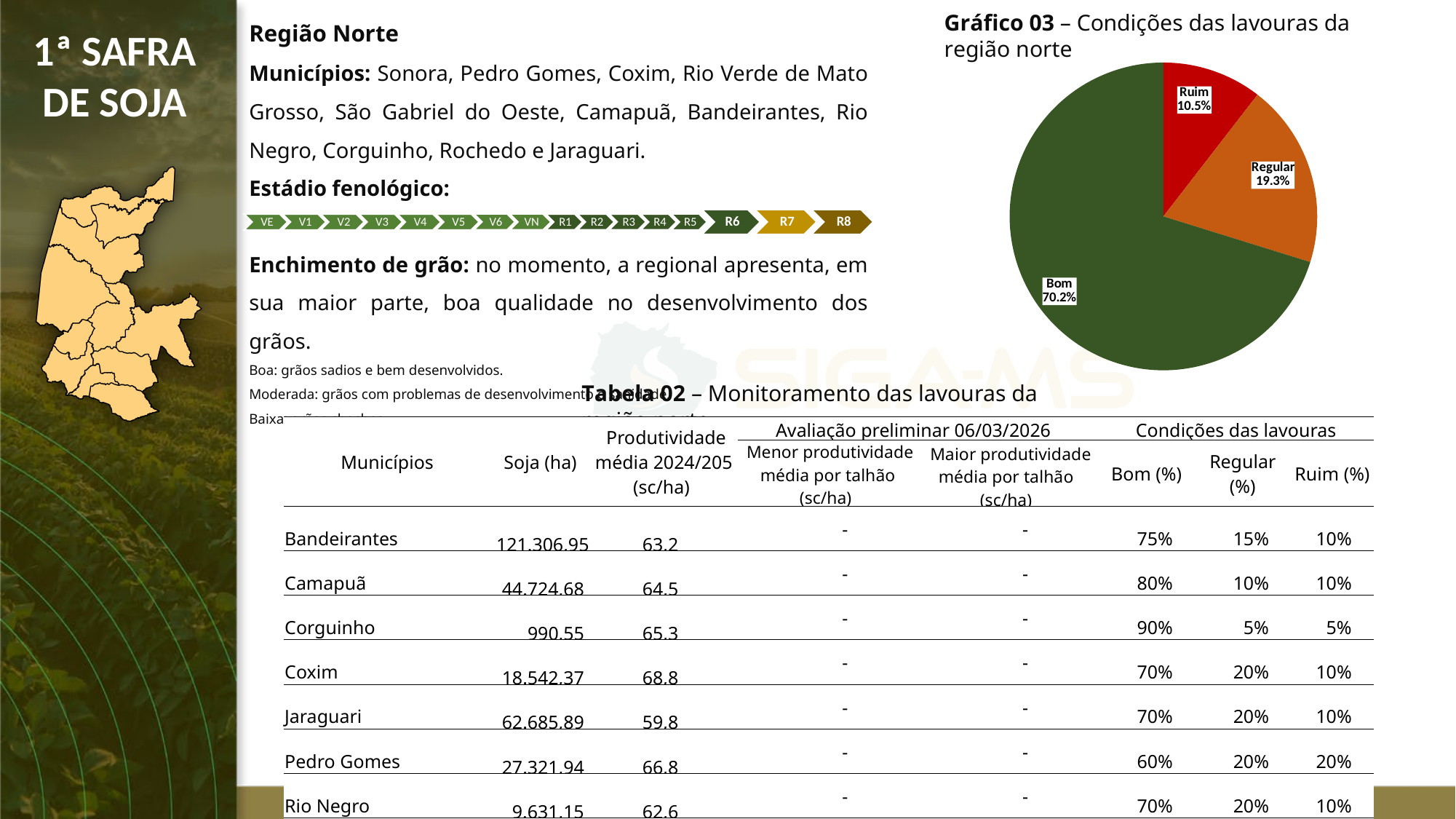
In Gráfico 03, what is the combined share of the 'Regular' and 'Ruim' slices? 29.8% In Gráfico 03, what share of the crops is in the 'Bom' condition? 70.2% In Gráfico 03, what is the difference in percentage points between the 'Bom' and 'Regular' slices? 50.9 In Gráfico 03, what share of the crops is in the 'Regular' condition? 19.3% In Gráfico 03, how many slices does the pie chart have? 3 In Gráfico 03, which slice is larger, 'Regular' or 'Ruim'? Regular In Gráfico 03, what is the difference in percentage points between the 'Regular' and 'Ruim' slices? 8.8 In Gráfico 03, which condition category has the smallest slice? Ruim What type of chart is Gráfico 03? Pie chart What is the title of the pie chart on the slide? Gráfico 03 – Condições das lavouras da região norte In Gráfico 03, which condition category has the largest slice? Bom In Gráfico 03, what share of the crops is in the 'Ruim' condition? 10.5%